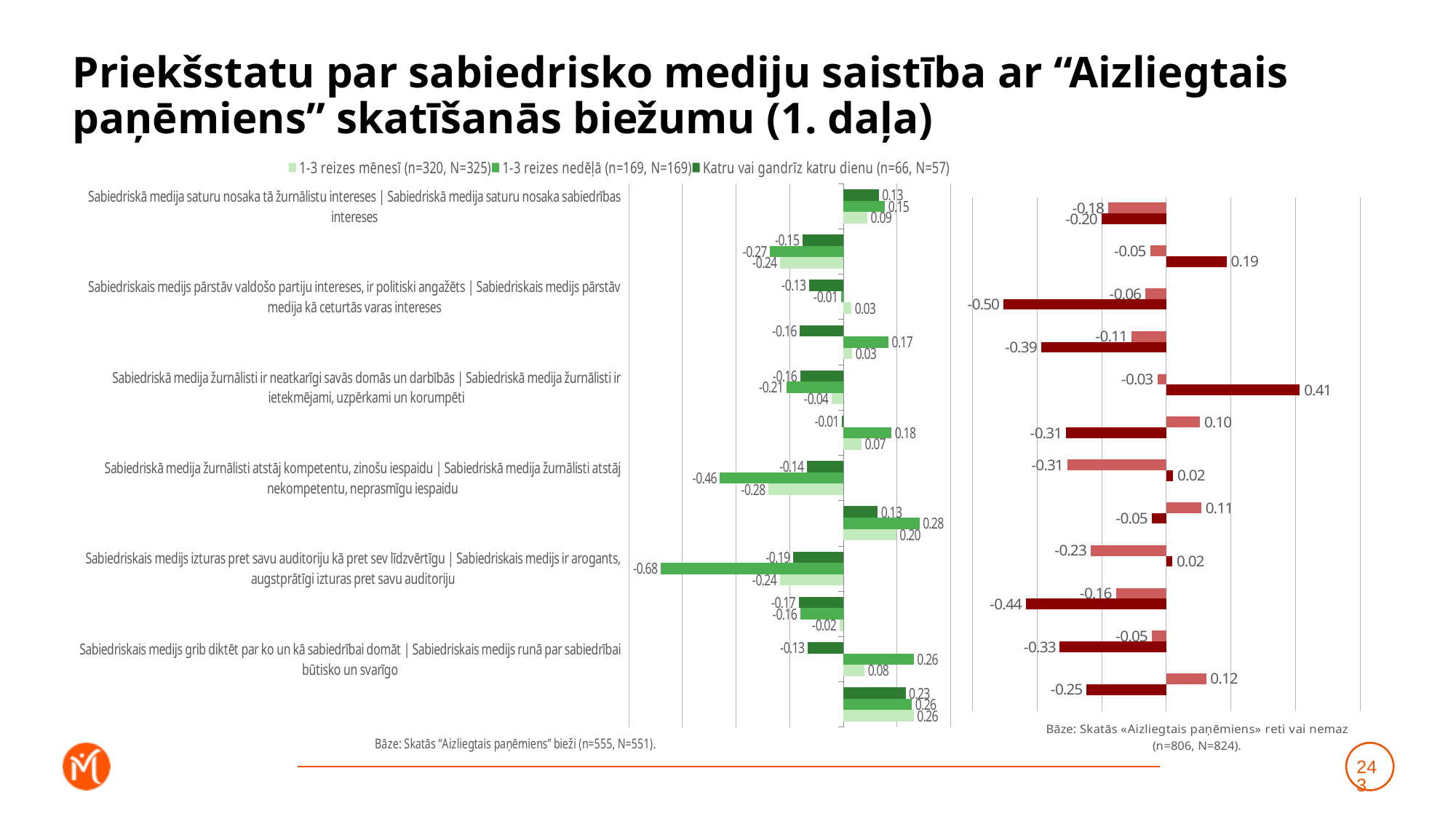
What kind of chart is the left-hand chart on the slide? bar chart In the left-hand (green) chart, what is the value of the 'Katru vai gandrīz katru dienu' series for 'Sabiedriskā medija saturu nosaka tā žurnālistu intereses | Sabiedriskā medija saturu nosaka sabiedrības intereses'? 0.13 How many series does the legend of the left-hand (green) chart list? 3 In the right-hand (red) chart, what is the value of the dark red bar for 'Sabiedriskais medijs pārstāv valdošo partiju intereses, ir politiski angažēts | Sabiedriskais medijs pārstāv medija kā ceturtās varas intereses'? -0.50 What is the base (Bāze) stated below the left-hand (green) chart? Skatās “Aizliegtais paņēmiens” bieži (n=555, N=551) In the left-hand (green) chart, what is the value of the '1-3 reizes nedēļā' series for 'Sabiedriskais medijs grib diktēt par ko un kā sabiedrībai domāt | Sabiedriskais medijs runā par sabiedrībai būtisko un svarīgo'? 0.26 In the right-hand (red) chart, what is the value of the dark red bar for 'Sabiedriskā medija žurnālisti ir neatkarīgi savās domās un darbībās | Sabiedriskā medija žurnālisti ir ietekmējami, uzpērkami un korumpēti'? 0.41 In the left-hand (green) chart, what is the value of the '1-3 reizes mēnesī' series for 'Sabiedriskā medija saturu nosaka tā žurnālistu intereses | Sabiedriskā medija saturu nosaka sabiedrības intereses'? 0.09 In the left-hand (green) chart, what is the difference between the 'Katru vai gandrīz katru dienu' value (-0.14) and the '1-3 reizes nedēļā' value (-0.46) for 'Sabiedriskā medija žurnālisti atstāj kompetentu, zinošu iespaidu | Sabiedriskā medija žurnālisti atstāj nekompetentu, neprasmīgu iespaidu'? 0.32 In the left-hand (green) chart, what is the value of the '1-3 reizes nedēļā' series for 'Sabiedriskais medijs izturas pret savu auditoriju kā pret sev līdzvērtīgu | Sabiedriskais medijs ir arogants, augstprātīgi izturas pret savu auditoriju'? -0.68 In the left-hand (green) chart, for 'Sabiedriskā medija saturu nosaka tā žurnālistu intereses | Sabiedriskā medija saturu nosaka sabiedrības intereses', which series has the larger value: '1-3 reizes nedēļā' or '1-3 reizes mēnesī'? 1-3 reizes nedēļā In the right-hand (red) chart, what is the value of the light red bar for 'Sabiedriskā medija žurnālisti atstāj kompetentu, zinošu iespaidu | Sabiedriskā medija žurnālisti atstāj nekompetentu, neprasmīgu iespaidu'? -0.31